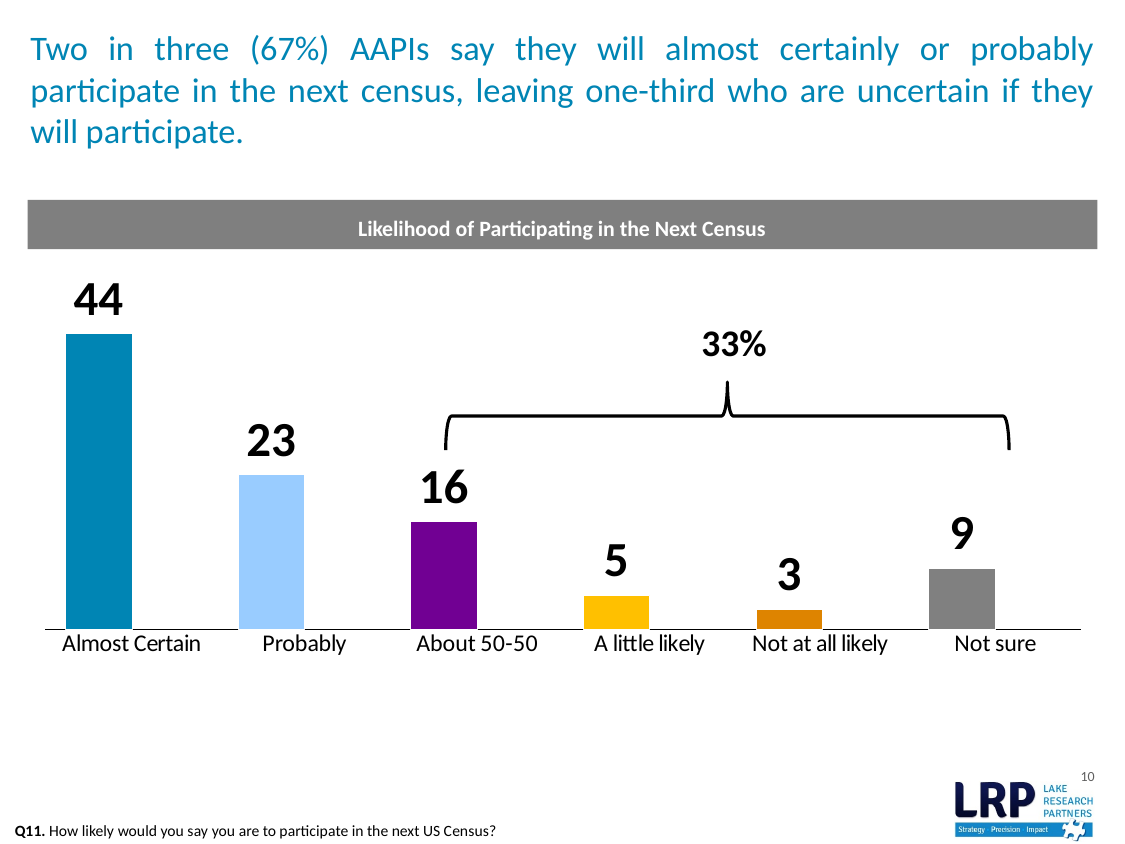
Which category has the lowest value? Not at all likely What kind of chart is shown on the slide? Bar chart What is the value for Not at all likely? 3 Which is larger, the value for Not sure or the value for A little likely? Not sure How many categories are shown on the chart? 6 Which category has the highest value? Almost Certain What is the value for About 50-50? 16 What is the value for Probably? 23 What percentage is shown above the bracket spanning About 50-50 through Not sure? 33% What is the difference between the values for Almost Certain and Probably? 21 What is the value for Almost Certain? 44 What is the title of the chart? Likelihood of Participating in the Next Census